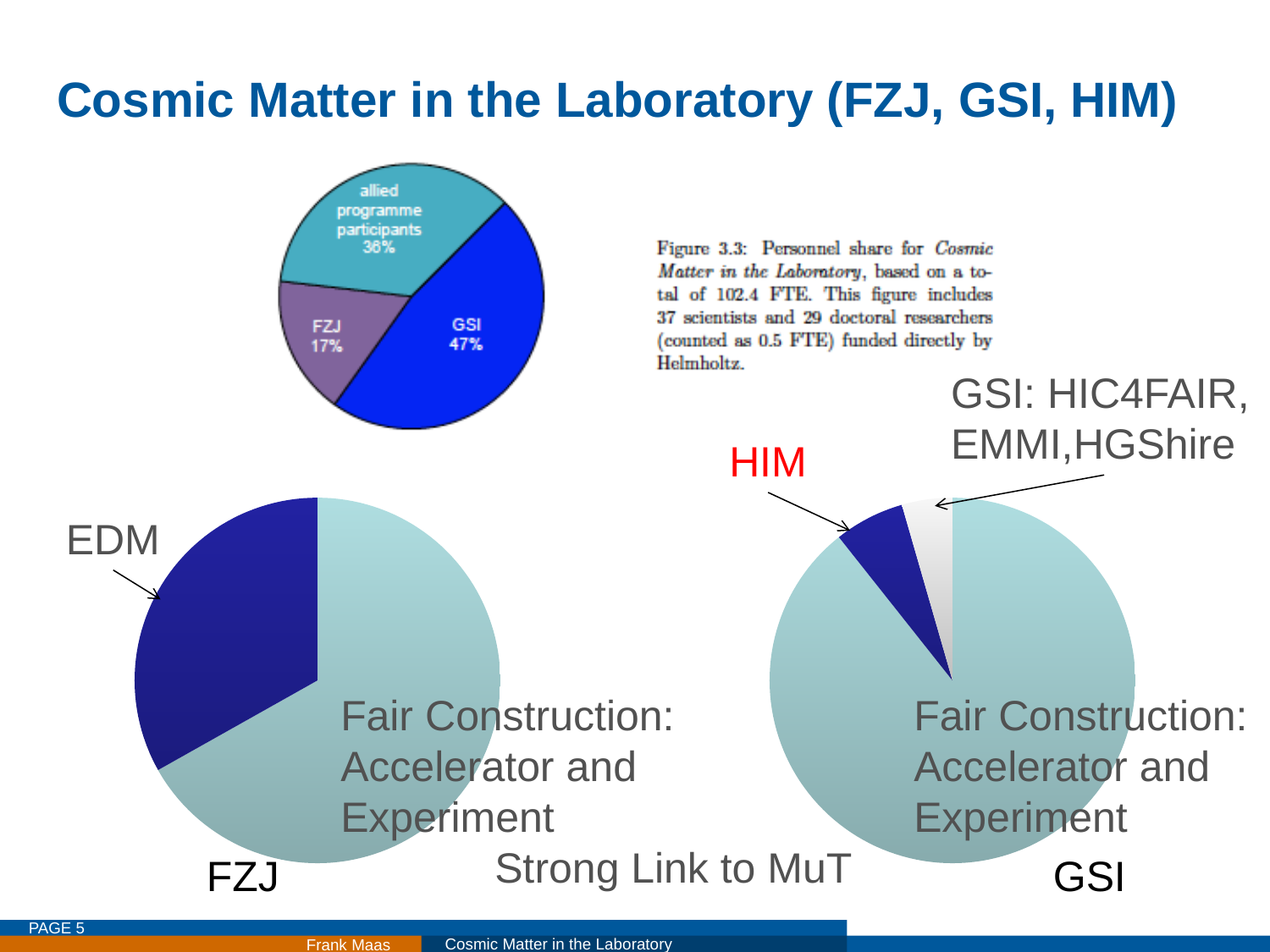
What kind of chart is the top chart showing personnel share? Pie chart In the top pie chart (personnel share), what is the difference in percentage points between the GSI share and the FZJ share? 30 percentage points In the top pie chart (personnel share), what percentage share do the allied programme participants have? 36% In the bottom-left pie chart labelled FZJ, which slice is larger: EDM or Fair Construction: Accelerator and Experiment? Fair Construction: Accelerator and Experiment How many slices does the top pie chart (personnel share) have? 3 In the top pie chart (personnel share), what percentage share does FZJ have? 17% In the bottom-right pie chart labelled GSI, which slice is the largest? Fair Construction: Accelerator and Experiment According to the caption next to the top pie chart, what total number of FTE is the personnel share based on? 102.4 FTE In the top pie chart (personnel share), which slice is the largest? GSI In the top pie chart (personnel share), which is larger: the GSI share or the allied programme participants share? GSI In the top pie chart (personnel share for Cosmic Matter in the Laboratory), what percentage share does GSI have? 47% In the top pie chart (personnel share), which slice is the smallest? FZJ